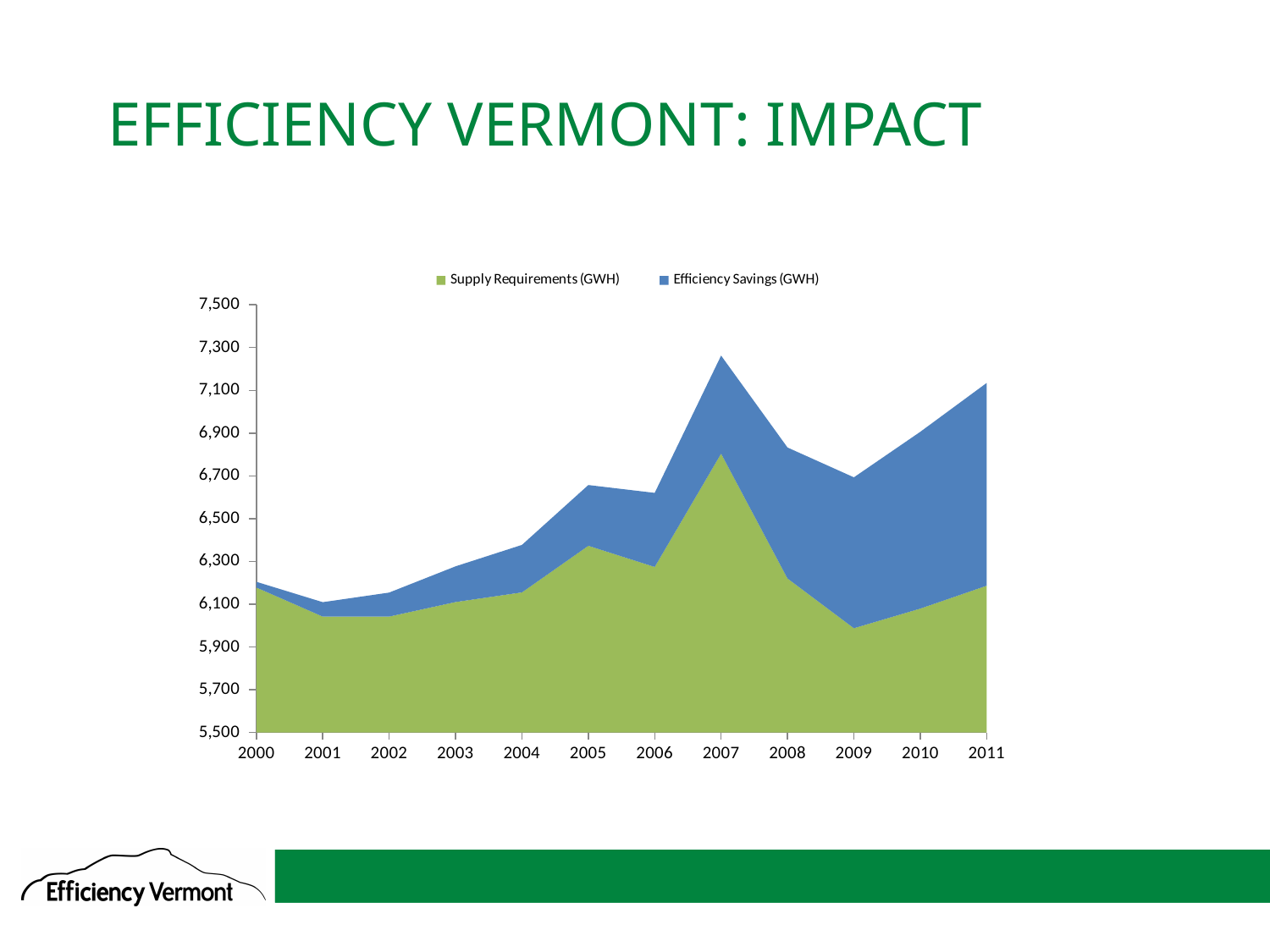
Is the Supply Requirements (GWH) value for 2009 greater or less than 6,100? less How many series does the legend list? 2 Is the Supply Requirements (GWH) value for 2007 greater or less than 6,500? greater In which year is the Efficiency Savings (GWH) band the widest? 2011 In which year is Supply Requirements (GWH) at its lowest? 2009 What kind of chart is shown on the slide? Area chart Is the top of the stacked area in 2007 greater or less than 7,100? greater Which colour represents Efficiency Savings (GWH) in the legend? Blue Does the Supply Requirements (GWH) value rise or fall from 2007 to 2009? fall In which year does Supply Requirements (GWH) reach its highest value? 2007 How many years are plotted along the x axis? 12